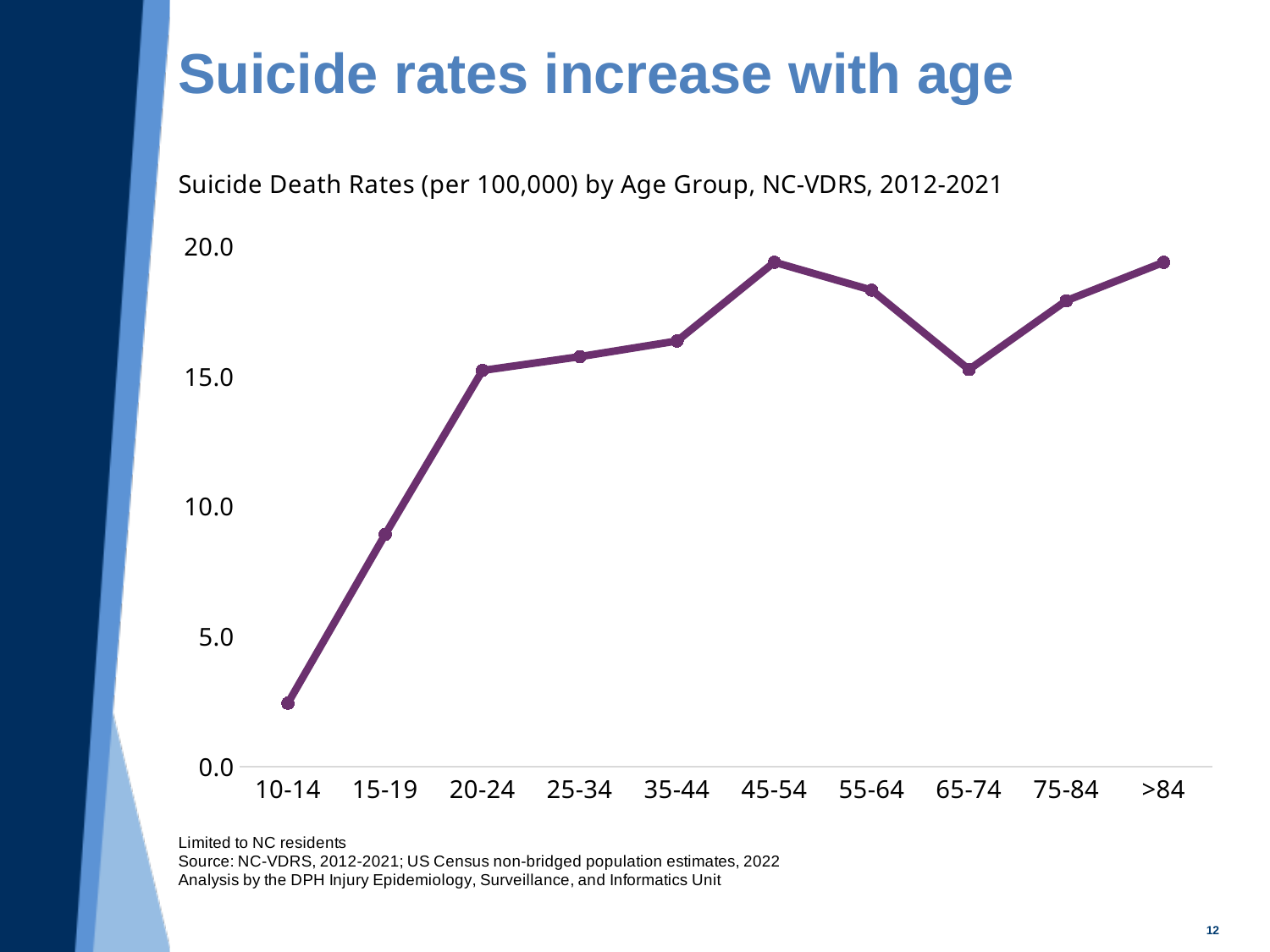
What colour is the plotted line? purple What kind of chart is shown on the slide? line chart Which age group has the lowest suicide death rate? 10-14 How many age groups are plotted on the x axis? 10 Which has a higher suicide death rate, the 15-19 age group or the 20-24 age group? 20-24 Which has a higher suicide death rate, the 55-64 age group or the 65-74 age group? 55-64 Is the value for the 45-54 age group greater or less than 15.0? greater Is the value for the 15-19 age group greater or less than 10.0? less Does the suicide death rate rise or fall from the 10-14 age group to the 45-54 age group? rise What is the title of the chart? Suicide Death Rates (per 100,000) by Age Group, NC-VDRS, 2012-2021 Is the value for the 10-14 age group greater or less than 5.0? less